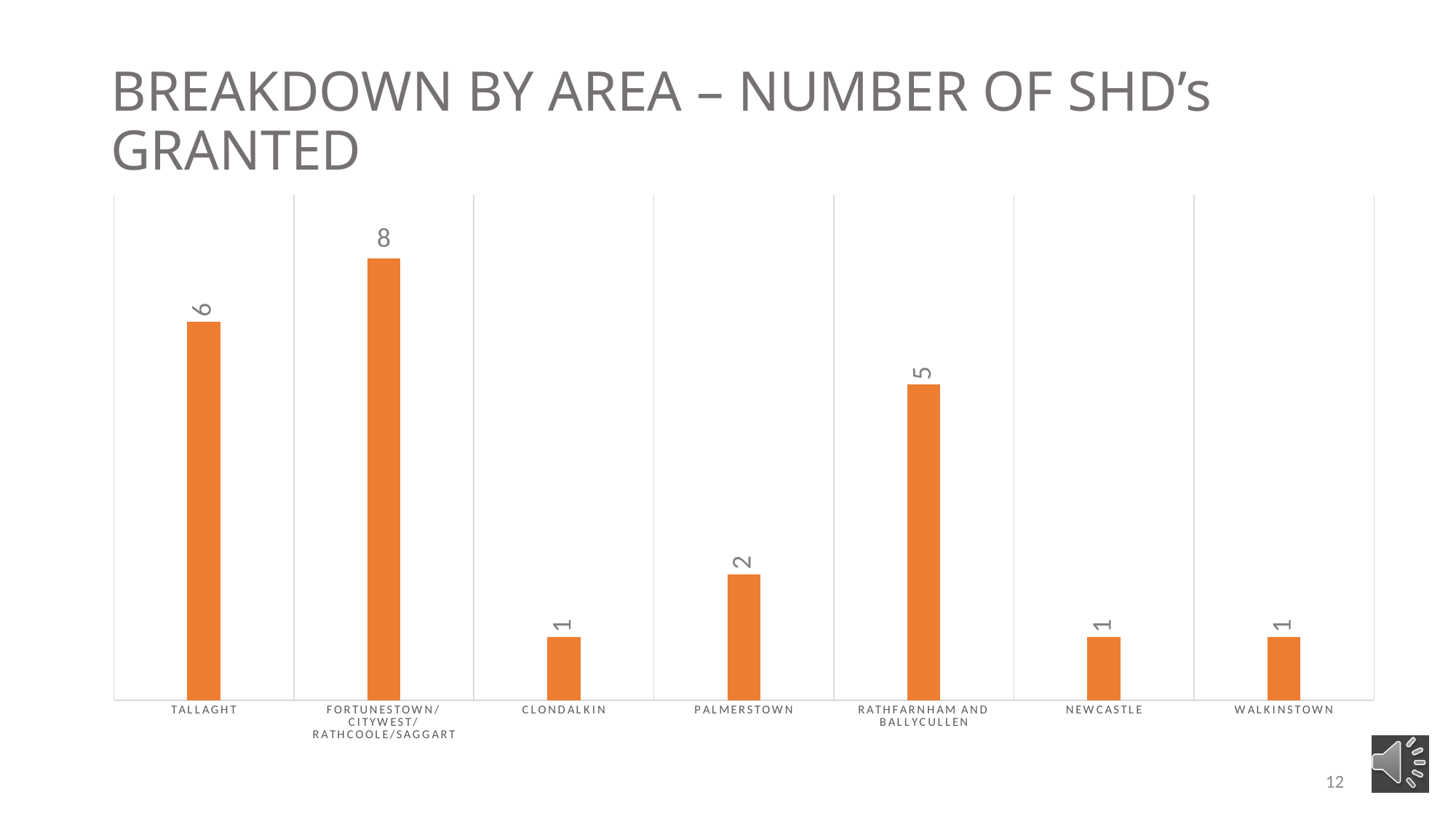
What is the title of the slide? BREAKDOWN BY AREA – NUMBER OF SHD's GRANTED How many SHD's were granted in Rathfarnham and Ballycullen? 5 What is the difference between the values for Rathfarnham and Ballycullen and Palmerstown? 3 What kind of chart is shown on the slide? Bar chart What is the value shown for Fortunestown/Citywest/Rathcoole/Saggart? 8 Which is larger, the value for Tallaght or the value for Rathfarnham and Ballycullen? Tallaght How many areas have a value of 1? 3 What is the value shown for Palmerstown? 2 What is the difference between the values for Fortunestown/Citywest/Rathcoole/Saggart and Tallaght? 2 Which area has the highest number of SHD's granted? Fortunestown/Citywest/Rathcoole/Saggart How many areas are shown on the chart? 7 How many SHD's were granted in Tallaght? 6